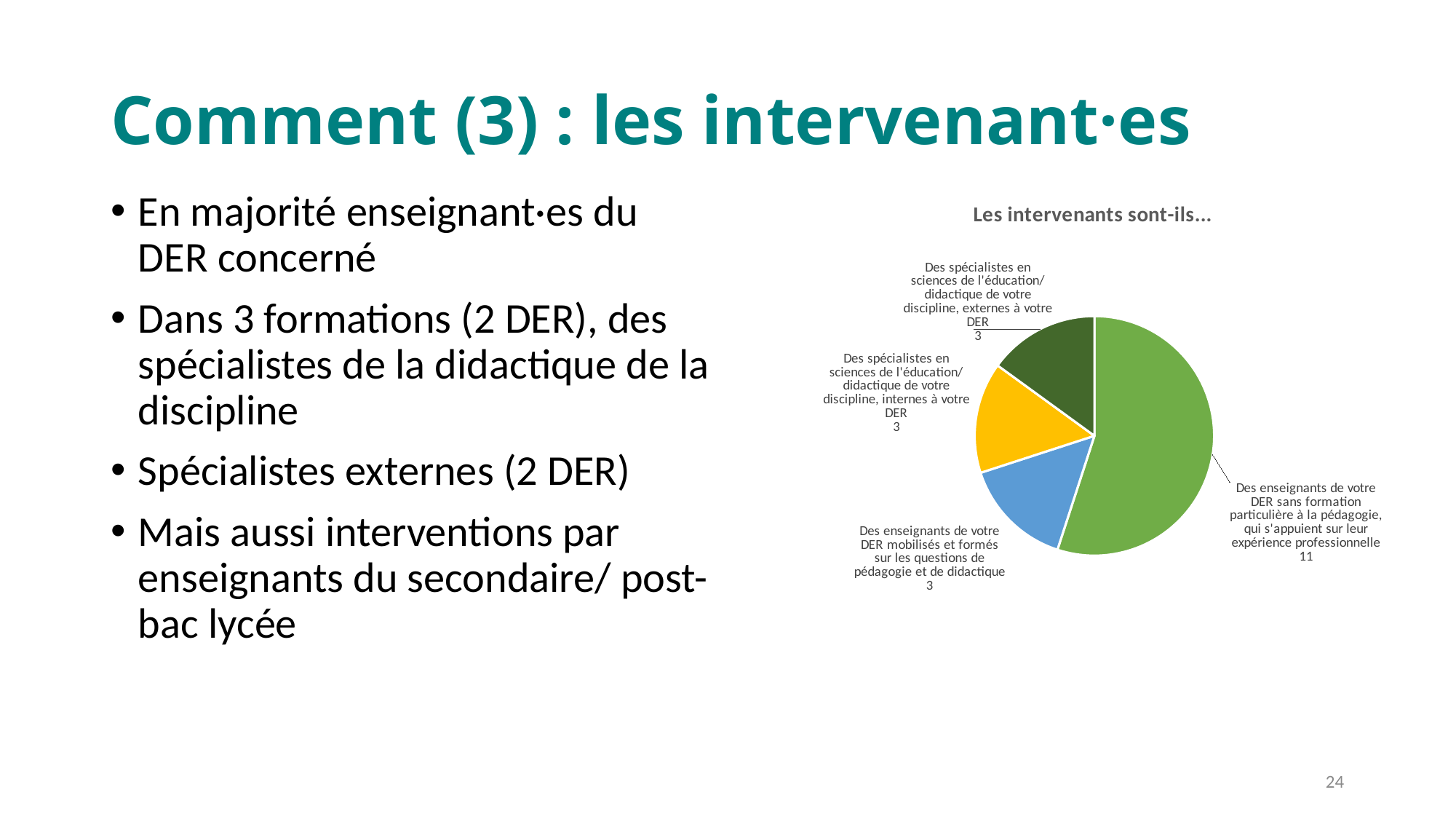
What is the title of the chart? Les intervenants sont-ils... What colour is the largest slice of the pie chart? green What is the value for "Des spécialistes en sciences de l'éducation/didactique de votre discipline, externes à votre DER"? 3 What is the value for "Des enseignants de votre DER mobilisés et formés sur les questions de pédagogie et de didactique"? 3 Which is larger: the value for enseignants de votre DER sans formation particulière or the value for enseignants de votre DER mobilisés et formés? Des enseignants de votre DER sans formation particulière What is the value for "Des enseignants de votre DER sans formation particulière à la pédagogie, qui s'appuient sur leur expérience professionnelle"? 11 How many slices does the pie chart have? 4 What is the total of all the slices in the pie chart? 20 What kind of chart is shown on the slide? pie chart What share of the pie does the slice for enseignants de votre DER sans formation particulière represent? 55% Which category has the largest slice of the pie? Des enseignants de votre DER sans formation particulière à la pédagogie, qui s'appuient sur leur expérience professionnelle What is the difference between the value for enseignants sans formation particulière (11) and the value for spécialistes internes à votre DER (3)? 8